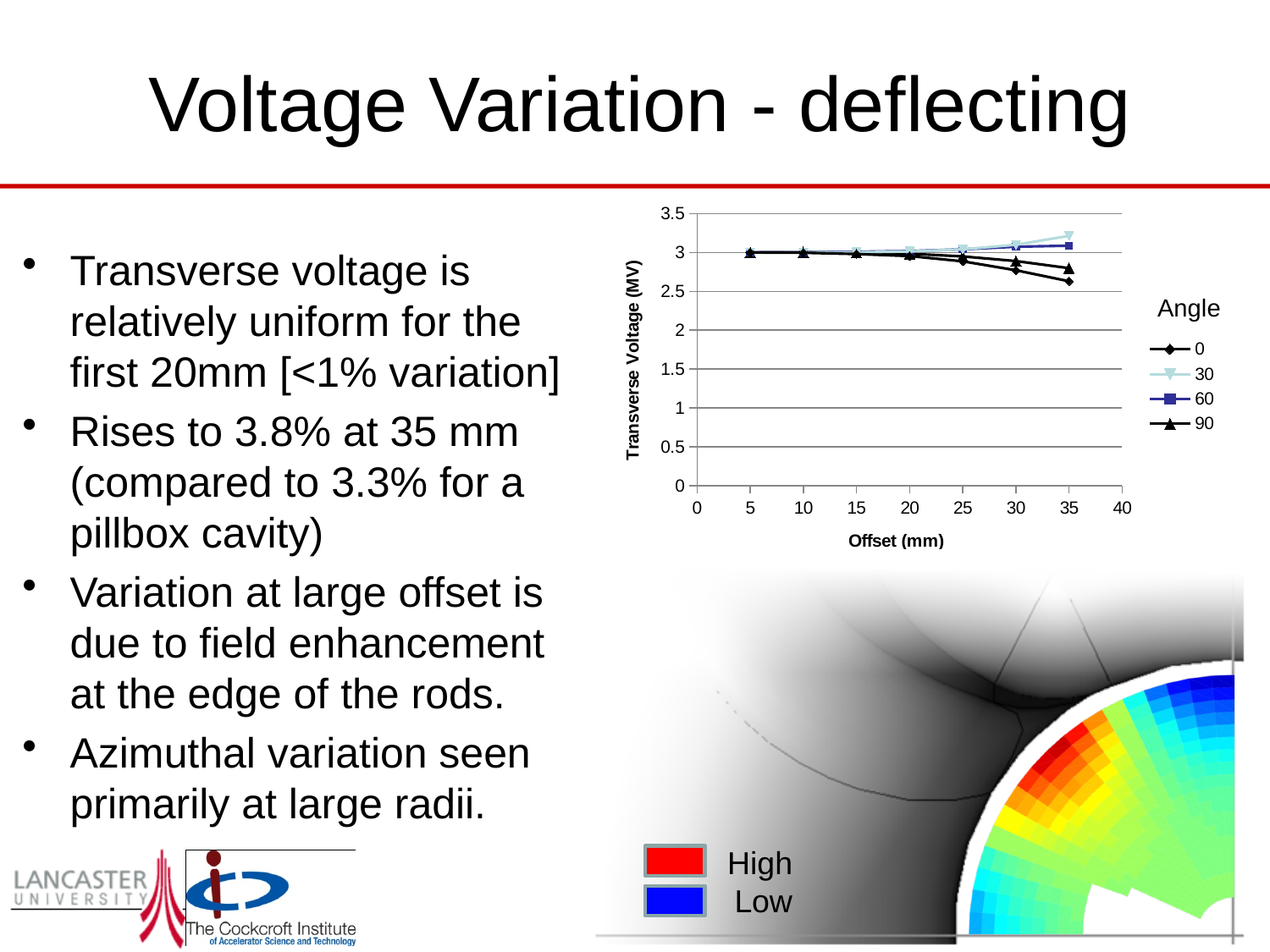
Is the transverse voltage for Angle 0 at 35 mm offset greater or less than 3? less At 35 mm offset, which series has the lowest transverse voltage? 0 How many series does the chart's legend list? 4 At 35 mm offset, which is larger: the transverse voltage for Angle 60 or for Angle 0? Angle 60 What kind of chart is shown on the slide? line chart What is the label of the chart's vertical axis? Transverse Voltage (MV) How many data points are plotted for the Angle 0 series? 7 At 35 mm offset, which series has the highest transverse voltage? 30 What is the title of the chart's legend? Angle Is the transverse voltage for Angle 30 at 35 mm offset greater or less than 3? greater Does the transverse voltage for Angle 30 rise or fall as the offset increases beyond 20 mm? rise Does the transverse voltage for Angle 0 rise or fall as the offset increases? fall